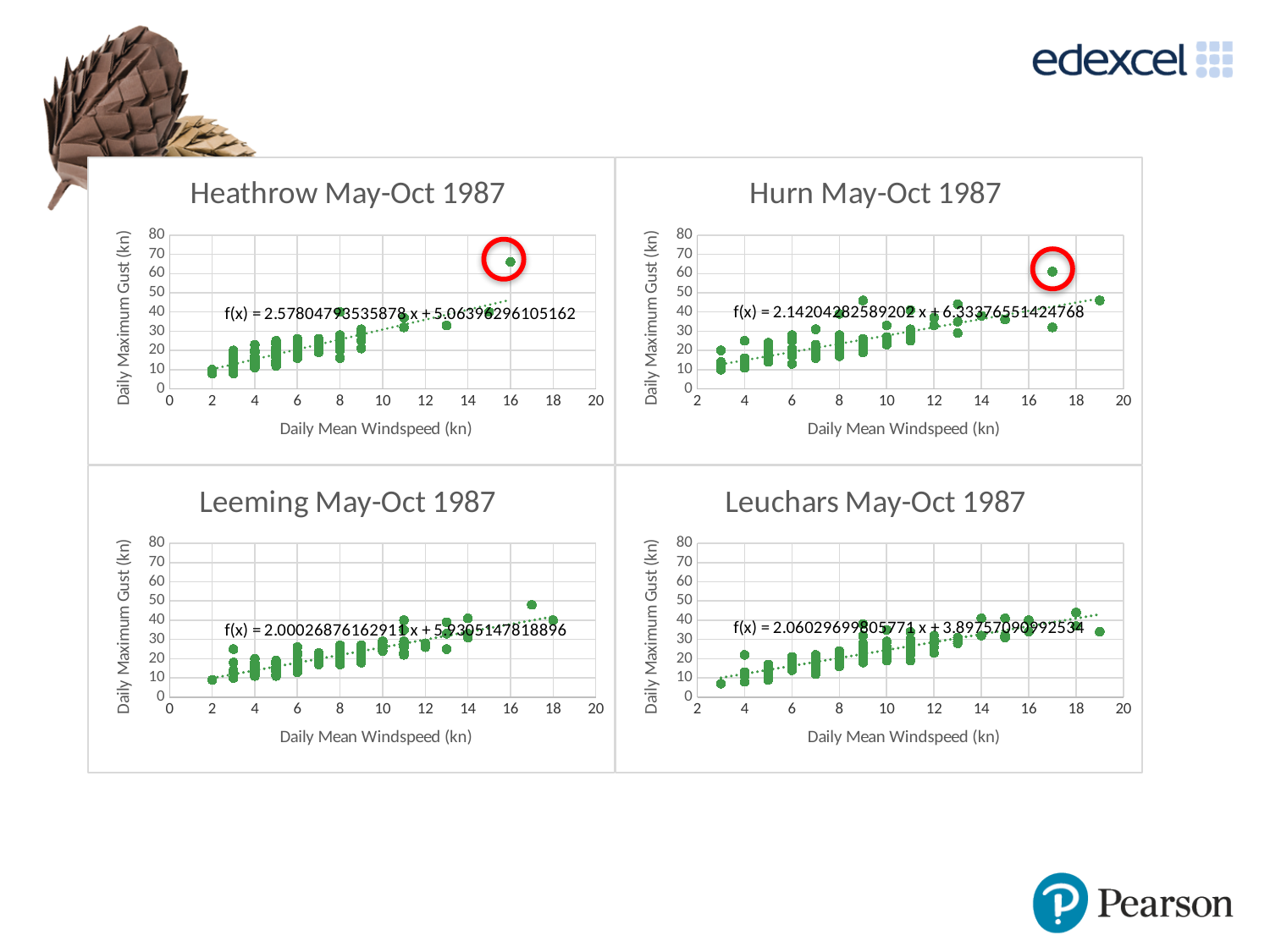
In the Leuchars May-Oct 1987 chart, is the highest plotted Daily Maximum Gust value greater or less than 50? less What kind of chart is the Heathrow May-Oct 1987 chart? scatter chart In the Heathrow May-Oct 1987 chart, is the value of the circled point greater or less than 60? greater What is the trendline equation shown on the Heathrow May-Oct 1987 chart? f(x) = 2.57804793535878 x + 5.06396296105162 In the Leeming May-Oct 1987 chart, is the highest plotted Daily Maximum Gust value greater or less than 60? less In the Leuchars May-Oct 1987 chart, do the plotted points generally rise or fall along the x axis? rise What is the title of the chart in the bottom-right position on the slide? Leuchars May-Oct 1987 What is the trendline equation shown on the Leeming May-Oct 1987 chart? f(x) = 2.00026876162911 x + 5.93051478188896 What is the x-axis title of the Hurn May-Oct 1987 chart? Daily Mean Windspeed (kn) How many charts are shown on the slide? 4 In the Heathrow May-Oct 1987 chart, do the values of Daily Maximum Gust generally rise or fall as Daily Mean Windspeed increases? rise